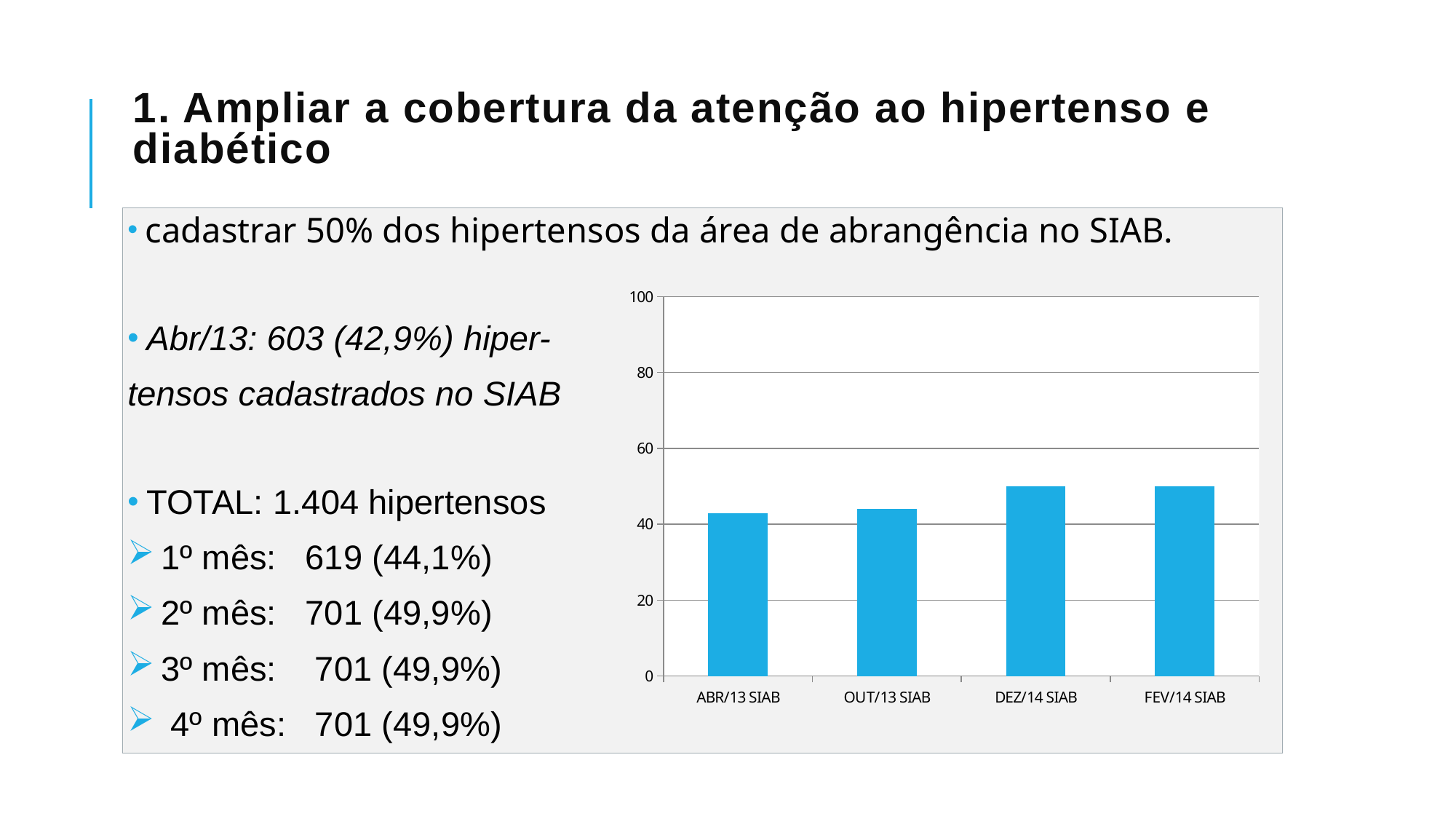
Is the value for DEZ/14 SIAB greater or less than 60? less What kind of chart is shown on the slide? bar chart Which is larger, the value for ABR/13 SIAB or the value for DEZ/14 SIAB? DEZ/14 SIAB Which is larger, the value for OUT/13 SIAB or the value for FEV/14 SIAB? FEV/14 SIAB What is the label of the first category on the x axis? ABR/13 SIAB Do the values generally rise or fall from ABR/13 SIAB to FEV/14 SIAB? rise Is the value for OUT/13 SIAB greater or less than 60? less What is the highest value shown on the vertical axis? 100 What colour are the bars in the chart? blue Is the value for FEV/14 SIAB greater or less than 40? greater How many bars (categories) does the chart show? 4